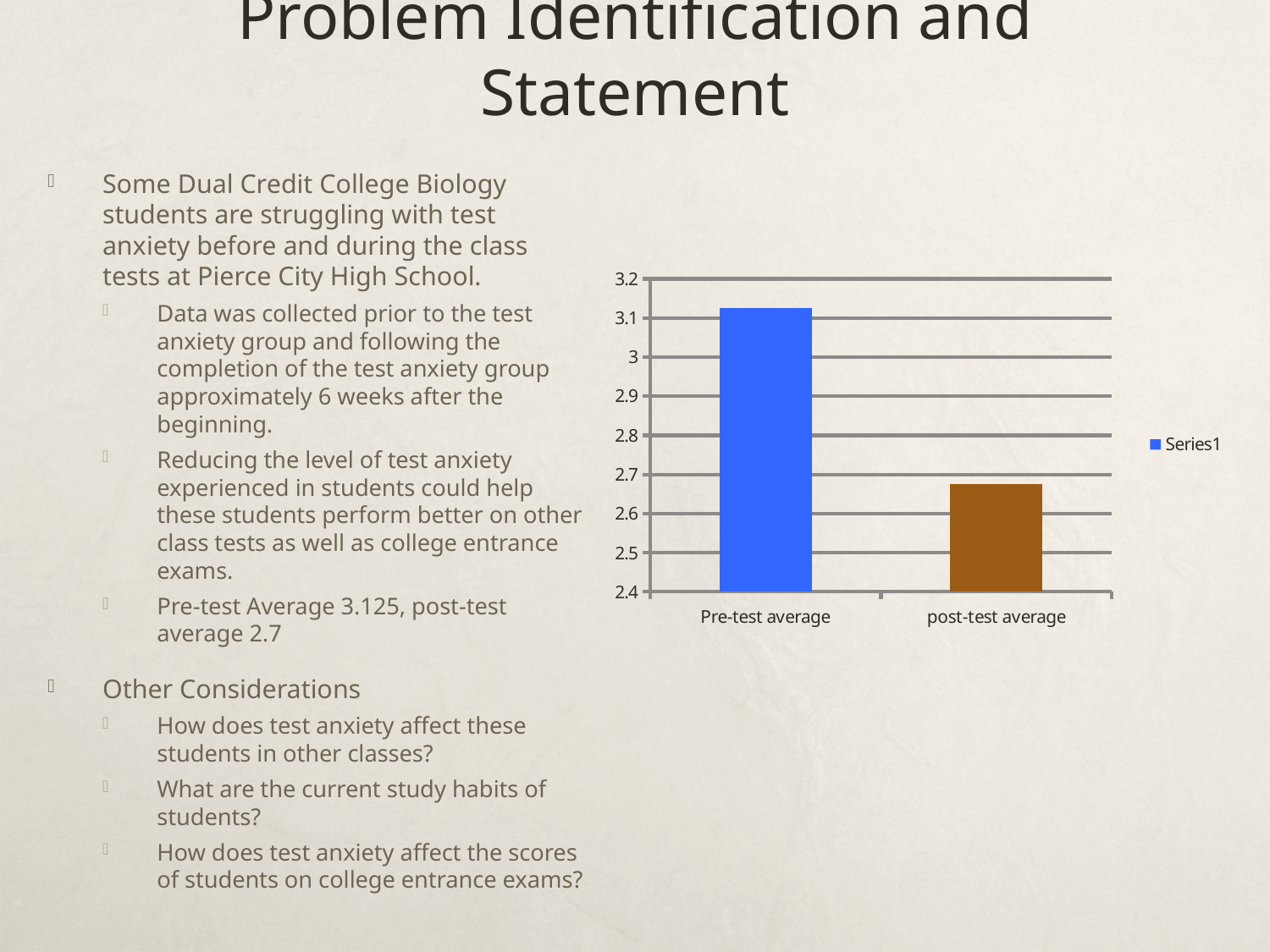
Which is larger, the Pre-test average or the post-test average? Pre-test average Is the value for post-test average greater or less than 2.8? less How many series does the chart legend list? 1 Do the values rise or fall from Pre-test average to post-test average? fall What kind of chart is shown on the slide? bar chart How many bars (categories) does the chart show? 2 Is the value for post-test average greater or less than 2.6? greater Which category has the highest value in the chart? Pre-test average Is the value for Pre-test average greater or less than 3? greater Which category has the lowest value in the chart? post-test average What is the name of the series shown in the chart legend? Series1 What colour is the bar for post-test average? brown